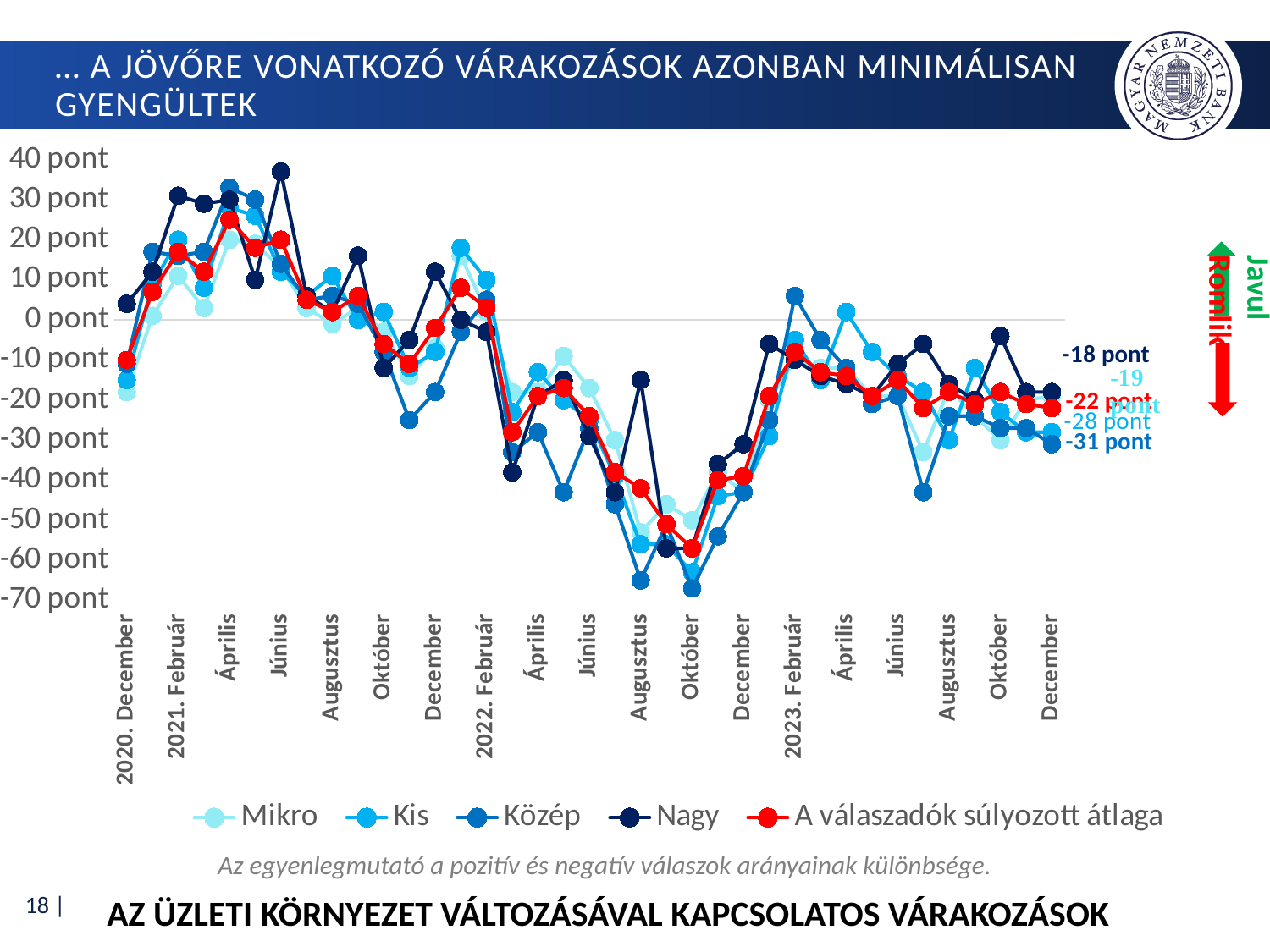
Is the value of the Közép series at 2022 Október greater or less than -60 pont? less Which series has the highest value at 2023 December according to the end labels? Nagy What is the value of the Nagy series at 2023 December, as labelled at the end of the line? -18 pont What is the value of 'A válaszadók súlyozott átlaga' at 2023 December, as labelled at the end of the line? -22 pont Is the value of the Nagy series at 2021 Június greater or less than 30 pont? greater What is the value of the Kis series at 2023 December, as labelled at the end of the line? -28 pont What is the difference between the Nagy and Közép end values at 2023 December? 13 pont At 2023 December, which is larger: the Kis value or the Közép value? Kis How many series does the legend list? 5 What kind of chart is shown on the slide? line chart Which series has the lowest value at 2023 December according to the end labels? Közép What is the value of the Közép series at 2023 December, as labelled at the end of the line? -31 pont